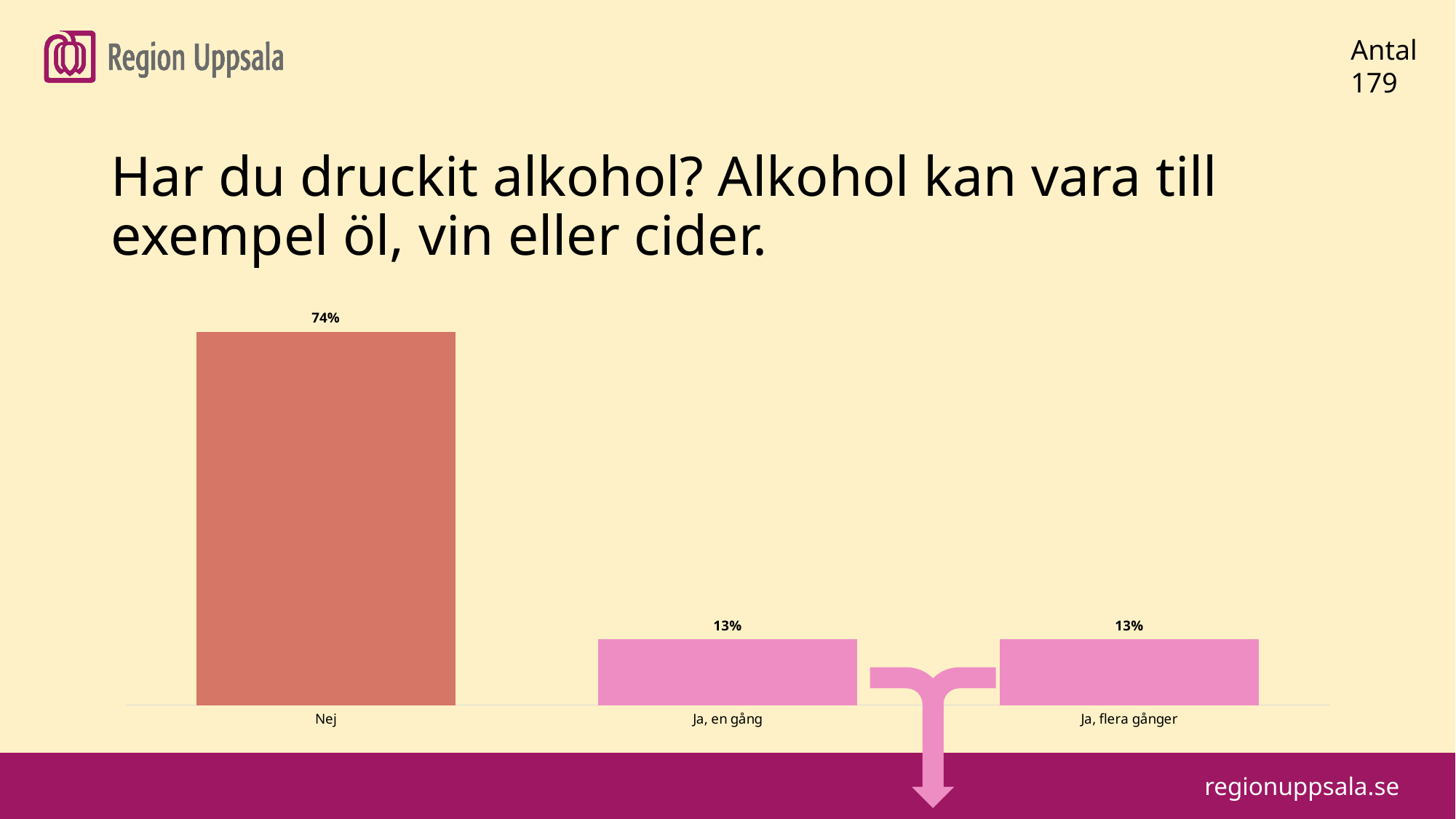
What is the number shown under "Antal" in the top right corner of the slide? 179 What is the value for "Ja, en gång"? 13% What is the total of the values for "Ja, en gång" and "Ja, flera gånger"? 26% What colour is the bar for "Nej"? Orange-red Which is larger, the value for "Nej" or the value for "Ja, flera gånger"? Nej How many categories are shown in the chart? 3 What kind of chart is shown on the slide? Bar chart What is the value for "Ja, flera gånger"? 13% What is the difference between the values for "Nej" and "Ja, en gång"? 61% What is the value for "Nej"? 74% Which category has the highest value? Nej